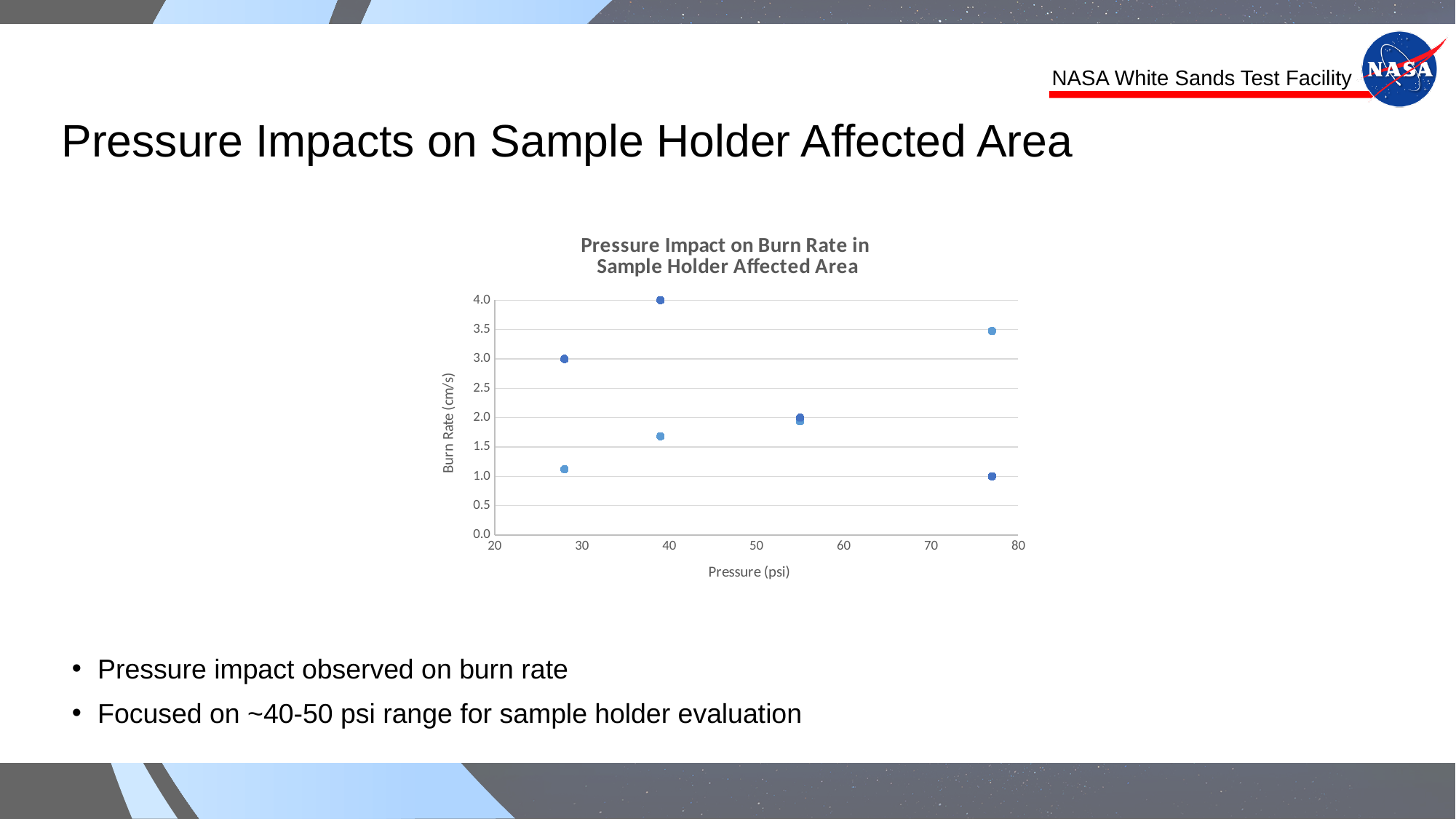
Is the lower burn rate point near 39 psi greater or less than 2.0? less Are the burn rate points near 55 psi greater or less than 1.5? greater Which is higher: the lower burn rate point near 28 psi or the lower burn rate point near 39 psi? the point near 39 psi What is the y-axis title of the chart? Burn Rate (cm/s) Which is higher: the top burn rate point near 39 psi or the top burn rate point near 77 psi? the point near 39 psi Is the highest burn rate plotted on the chart greater or less than 3.5? greater What kind of chart is shown on the slide? scatter chart What is the title of the chart? Pressure Impact on Burn Rate in Sample Holder Affected Area